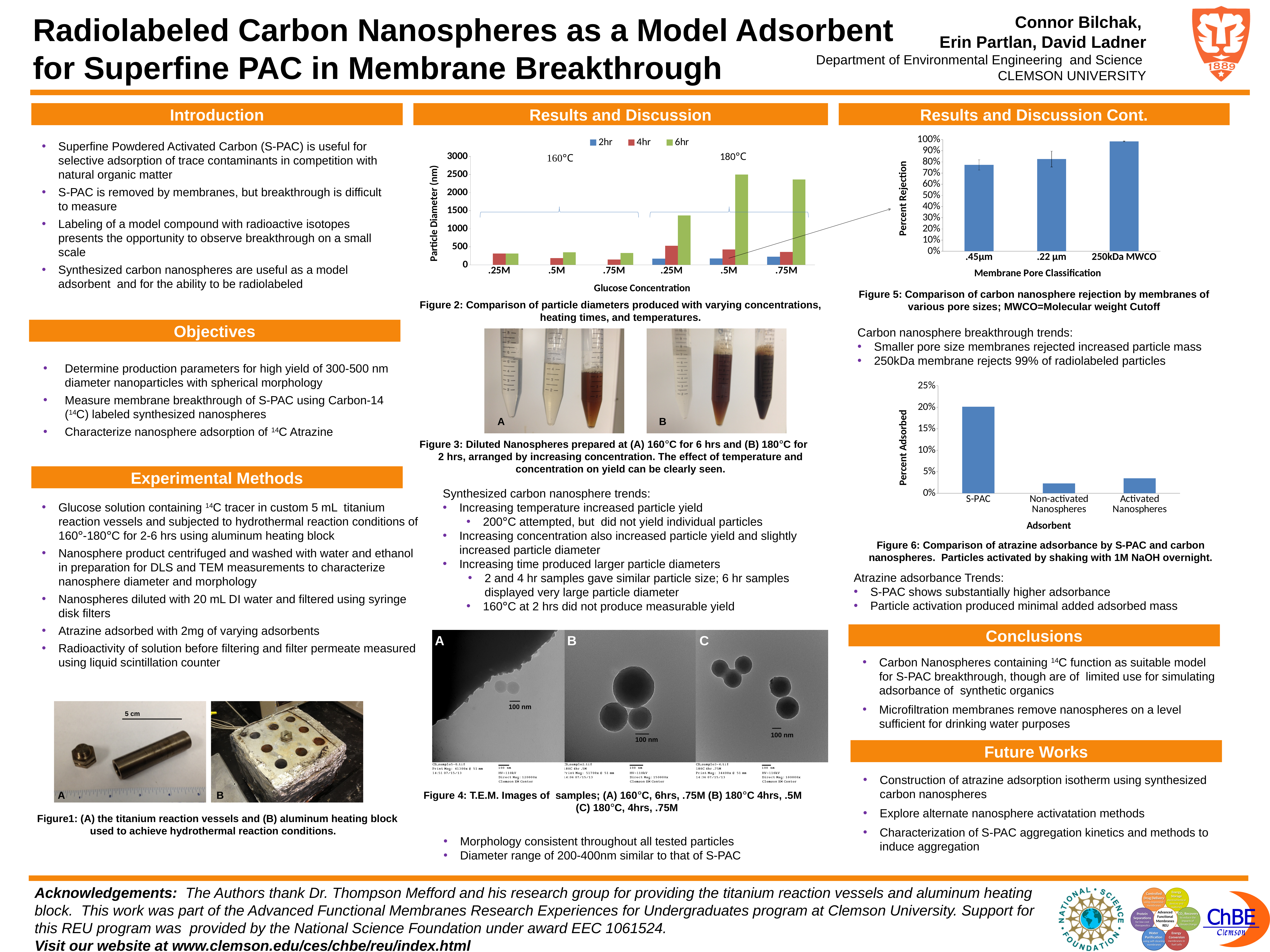
In Figure 6 (percent adsorbed chart), which adsorbent has the highest percent adsorbed? S-PAC In Figure 2 (particle diameter chart), is the 4hr value at .25M under 160°C greater or less than 500? less In Figure 6 (percent adsorbed chart), is the value for S-PAC greater or less than 15%? greater In Figure 2 (particle diameter chart), how many series does the legend list? 3 In Figure 2 (particle diameter chart), which series has the tallest bar at .5M under 180°C? 6hr In Figure 2 (particle diameter chart), what are the legend entries? 2hr, 4hr, 6hr In Figure 2 (particle diameter chart), is the 6hr value at .5M under 180°C greater or less than 2000? greater In Figure 5 (percent rejection chart), which membrane pore classification has the lowest percent rejection? .45µm In Figure 6 (percent adsorbed chart), how many adsorbent categories are shown on the x axis? 3 In Figure 5 (percent rejection chart), which membrane pore classification has the highest percent rejection? 250kDa MWCO